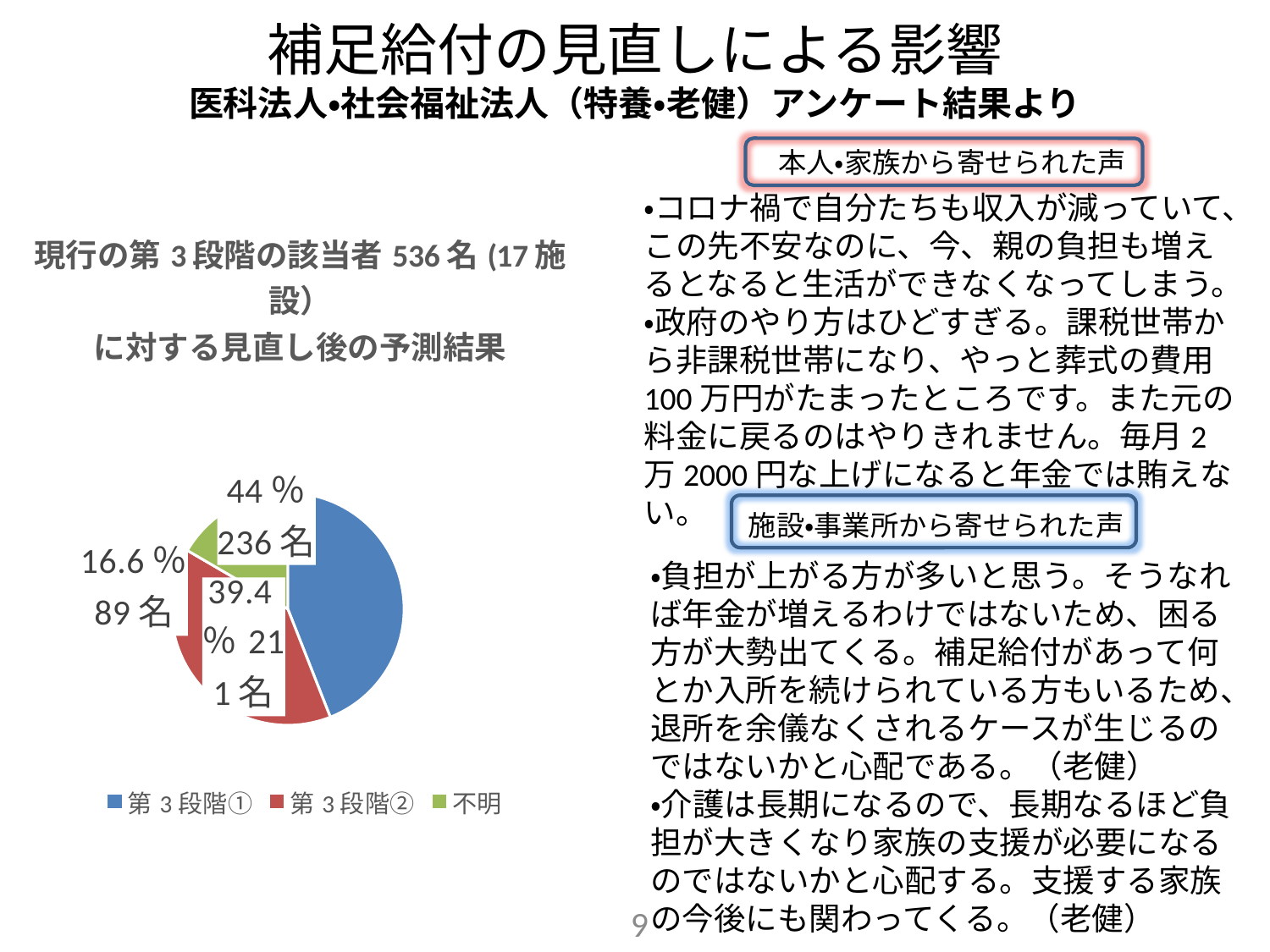
What percentage does the 第3段階② slice represent in the pie chart? 39.4% Which slice of the pie chart is the smallest? 不明 How many people (名) are in the 不明 slice of the pie chart? 89名 What percentage does the 第3段階① slice represent in the pie chart? 44% Which colour represents 不明 in the pie chart? green Which slice of the pie chart is the largest? 第3段階① What is the difference in number of people between the 第3段階① slice and the 不明 slice? 147名 How many slices does the pie chart have? 3 How many people (名) are in the 第3段階① slice of the pie chart? 236名 How many entries does the legend of the pie chart list? 3 What kind of chart is shown on the slide? pie chart What percentage does the 不明 slice represent in the pie chart? 16.6%